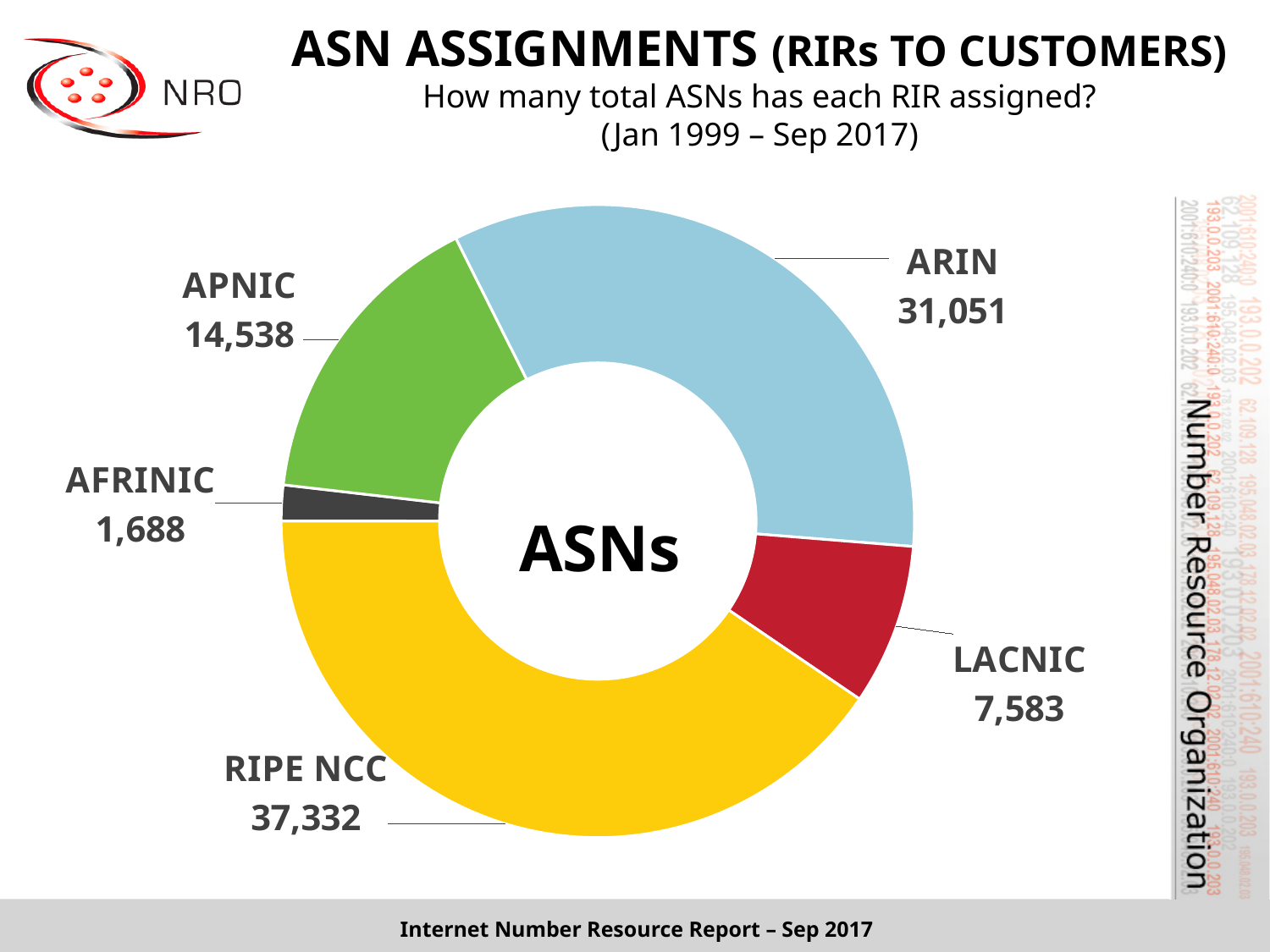
What is the value shown for RIPE NCC? 37,332 What is the difference between the APNIC and LACNIC values? 6,955 Which has assigned more ASNs, APNIC or LACNIC? APNIC What label is printed in the centre of the chart? ASNs How many ASNs has ARIN assigned according to the chart? 31,051 What kind of chart is shown on the slide? Pie (donut) chart How many more ASNs has RIPE NCC assigned than ARIN? 6,281 Which RIR has assigned the fewest ASNs? AFRINIC What value is shown for LACNIC? 7,583 How many ASNs has AFRINIC assigned? 1,688 Which RIR has assigned the most ASNs? RIPE NCC How many RIRs are shown in the chart? 5